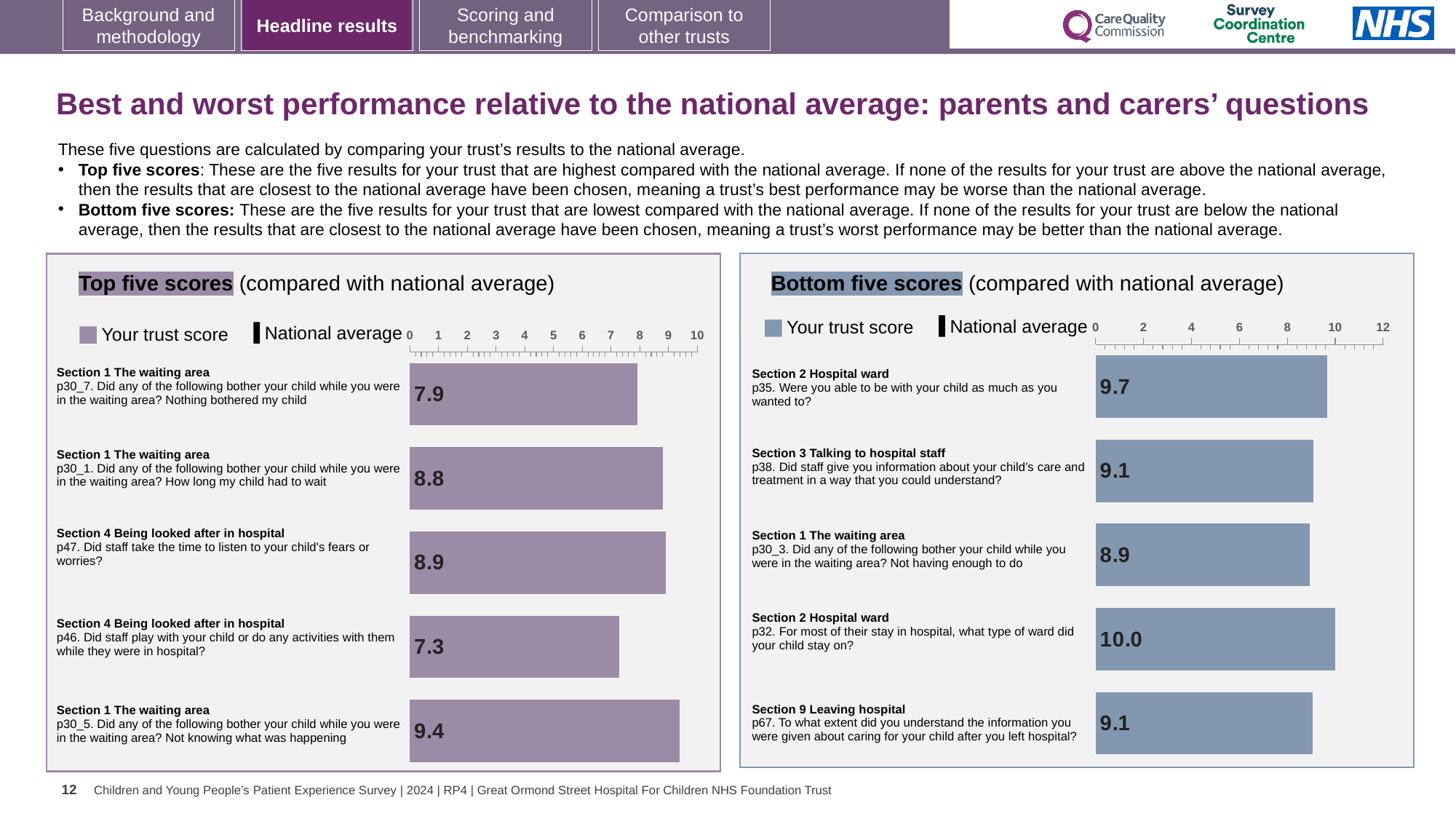
In the Top five scores chart, what is the trust score for p30_7 (Nothing bothered my child in the waiting area)? 7.9 In the Bottom five scores chart, which question has the lowest trust score? p30_3. Not having enough to do (8.9) In the Top five scores chart, what is the trust score for p46 (Did staff play with your child or do any activities with them)? 7.3 What type of chart is used for the Top five scores? Bar chart In the Top five scores chart, what is the difference between the scores for p30_5 and p46? 2.1 In the Bottom five scores chart, what is the trust score for p35 (Were you able to be with your child as much as you wanted to)? 9.7 In the Top five scores chart, which question has the highest trust score? p30_5. Not knowing what was happening (9.4) In the Bottom five scores chart, which question has the highest trust score? p32. What type of ward did your child stay on (10.0) In the Top five scores chart, which question has the lowest trust score? p46. Did staff play with your child or do any activities with them (7.3) How many bars are shown in the Bottom five scores chart? 5 How many series does the legend of the Top five scores chart list? 2 In the Bottom five scores chart, is the score for p38 larger or smaller than the score for p35? smaller